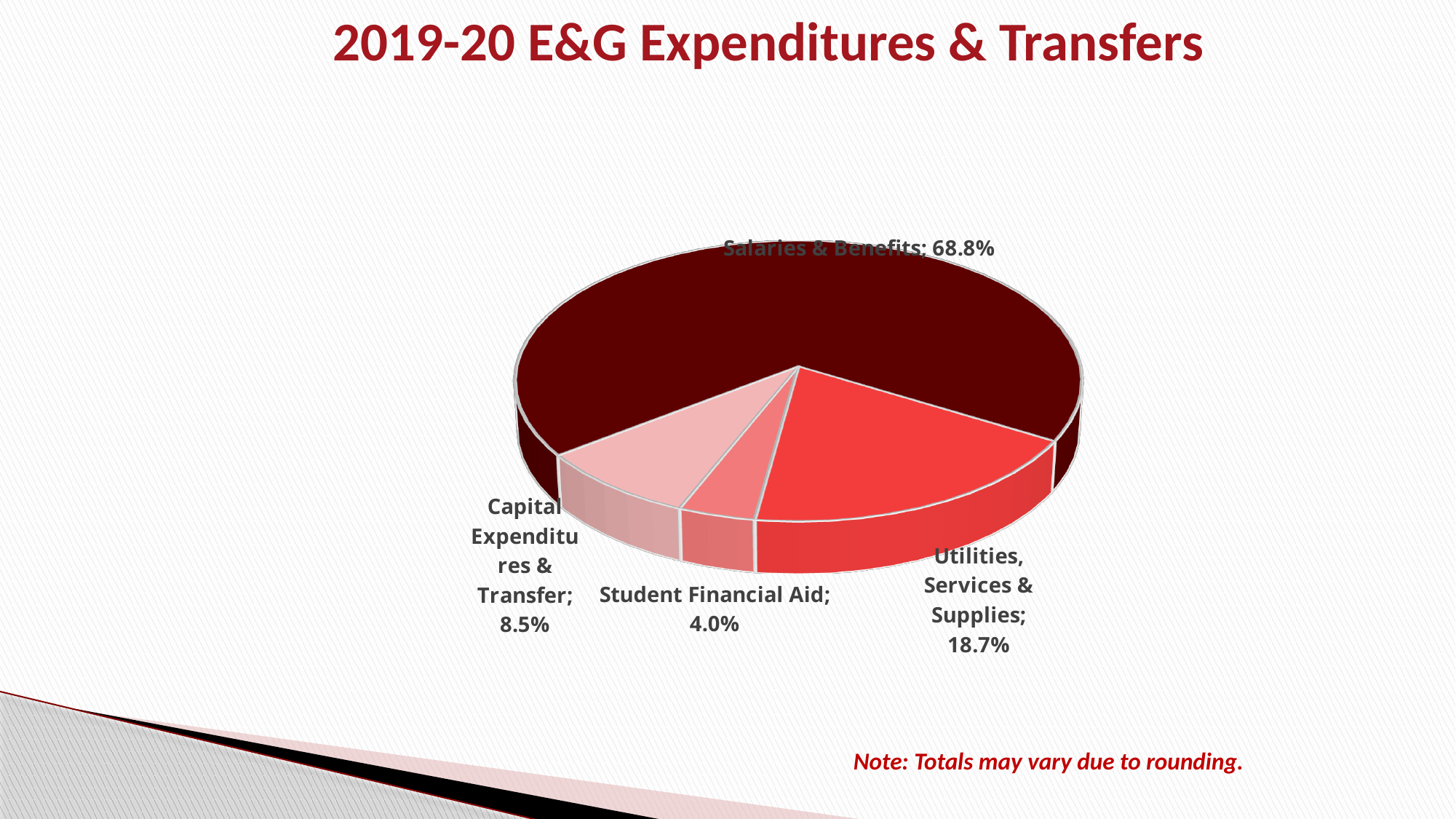
What is the difference in percentage points between Salaries & Benefits and Utilities, Services & Supplies? 50.1 What percentage is shown for Student Financial Aid? 4.0% Which is larger, Capital Expenditures & Transfer or Student Financial Aid? Capital Expenditures & Transfer How many categories are shown in the pie chart? 4 What share of 2019-20 E&G Expenditures & Transfers is Salaries & Benefits? 68.8% What percentage is shown for Capital Expenditures & Transfer? 8.5% What is the title of the chart? 2019-20 E&G Expenditures & Transfers Which category has the largest share of the pie? Salaries & Benefits What is the difference in percentage points between Capital Expenditures & Transfer and Student Financial Aid? 4.5 What kind of chart is shown on the slide? Pie chart What share of the pie is Utilities, Services & Supplies? 18.7% Which category has the smallest share of the pie? Student Financial Aid